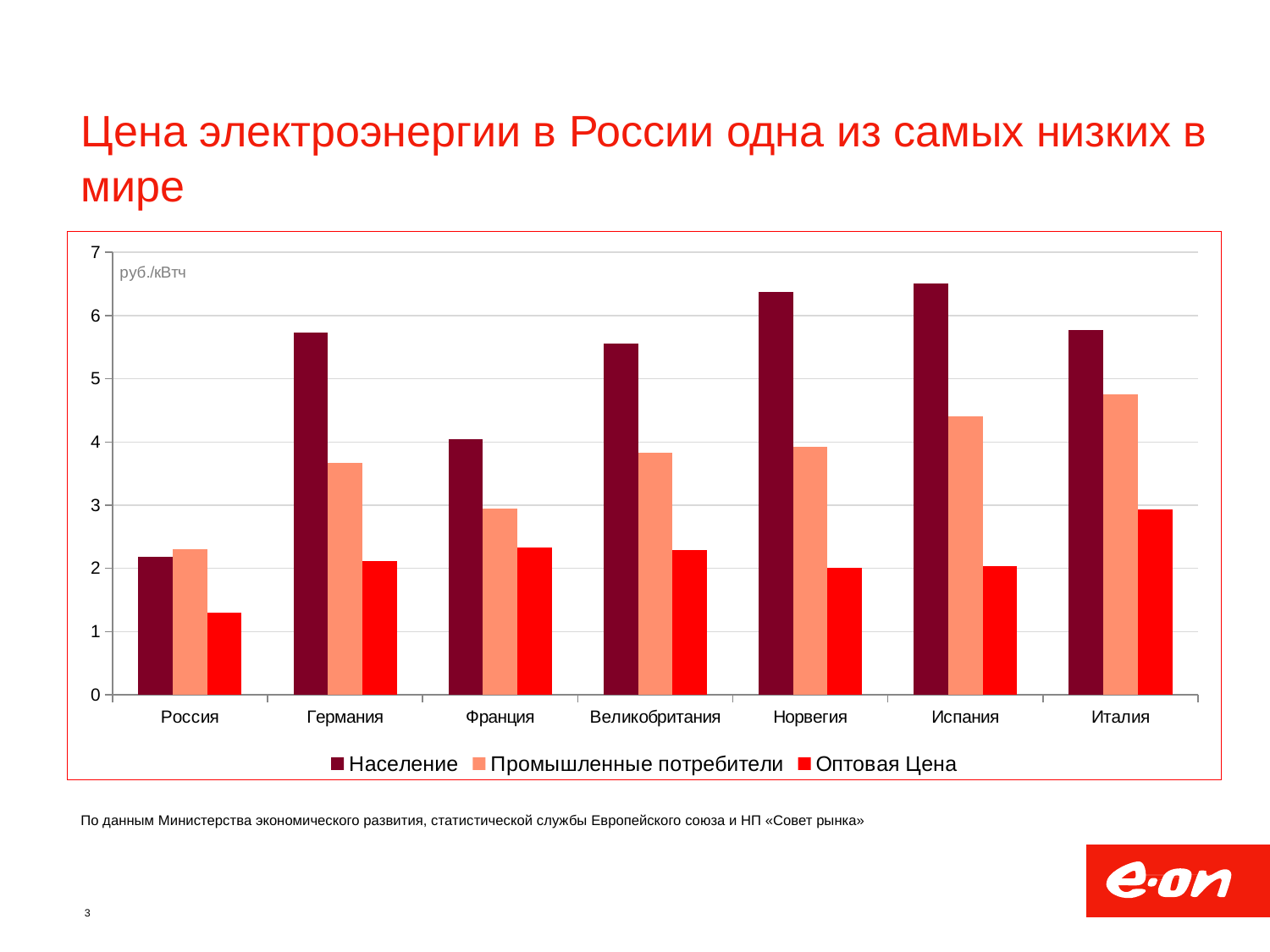
What kind of chart is shown on the slide? bar chart Is the value for Население in Россия greater or less than 3? less Which country has the highest value for Промышленные потребители? Италия Which country has the lowest value for Оптовая Цена? Россия Is the value for Население in Норвегия greater or less than 6? greater Is the value for Промышленные потребители in Италия greater or less than 4? greater Which country has the lowest value for Население? Россия How many countries are shown on the x axis of the chart? 7 What unit is shown in the top-left corner of the chart's plot area? руб./кВтч Which country has the highest value for Оптовая Цена? Италия How many series does the chart legend list? 3 Which is larger: the Население value for Германия or for Франция? Германия